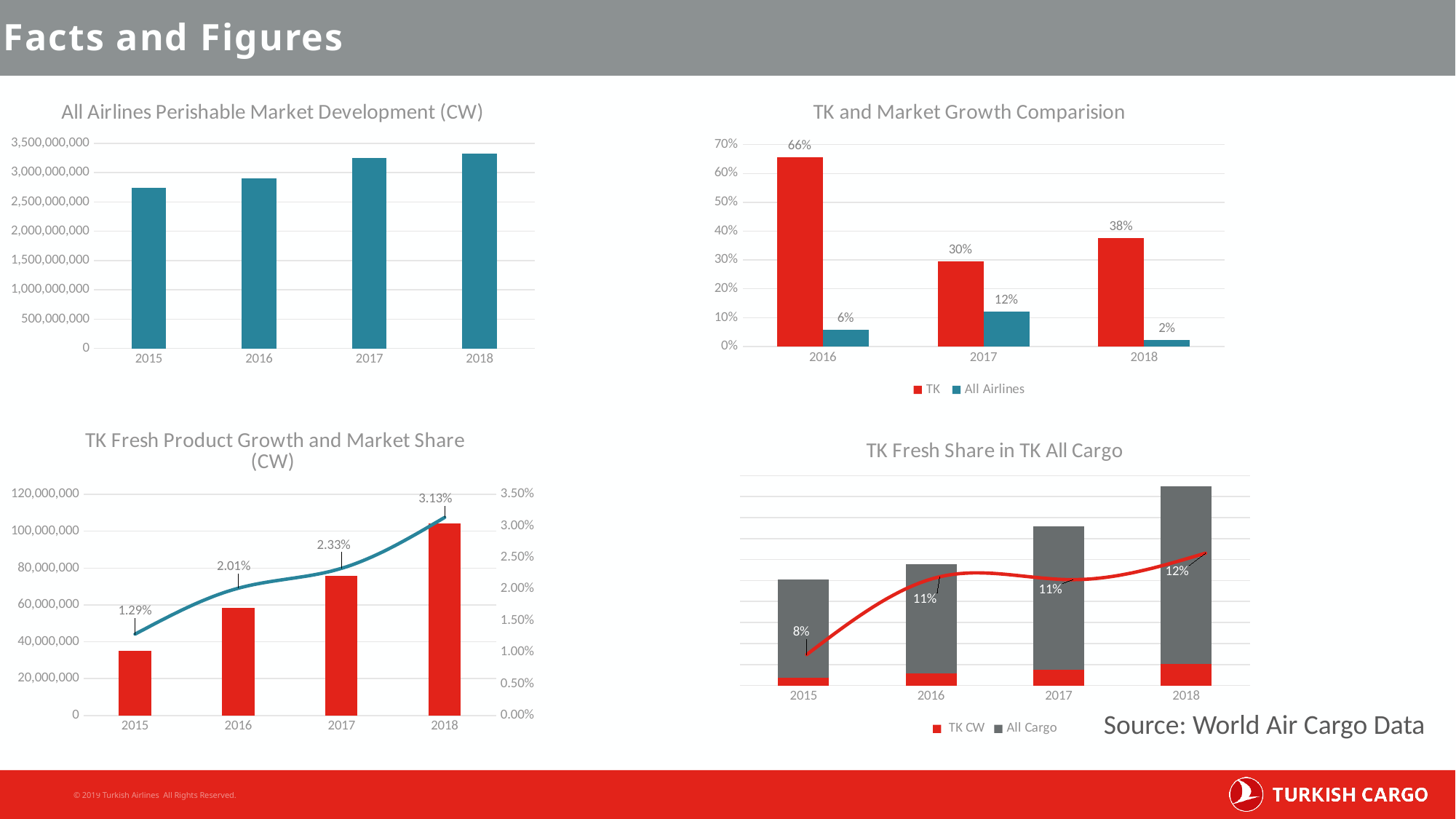
In the 'All Airlines Perishable Market Development (CW)' chart, do the values rise or fall from 2015 to 2018? rise In the 'TK and Market Growth Comparision' chart, what is the All Airlines value for 2017? 12% In the 'TK Fresh Product Growth and Market Share (CW)' chart, what is the market share value shown for 2017? 2.33% In the 'All Airlines Perishable Market Development (CW)' chart, is the value for 2015 greater or less than 3,000,000,000? less In the 'TK and Market Growth Comparision' chart, what is the difference between the TK and All Airlines values for 2018? 36% In the 'TK and Market Growth Comparision' chart, what is the TK value for 2016? 66% In the 'TK Fresh Product Growth and Market Share (CW)' chart, is the bar value for 2018 greater or less than 100,000,000? greater In the 'TK and Market Growth Comparision' chart, which year has the lowest All Airlines value? 2018 In the 'TK Fresh Share in TK All Cargo' chart, what is the share value labelled for 2015? 8% In the 'All Airlines Perishable Market Development (CW)' chart, how many years are shown on the x axis? 4 In the 'TK Fresh Product Growth and Market Share (CW)' chart, which year has the highest market share value on the line? 2018 In the 'TK and Market Growth Comparision' chart, how many series does the legend list? 2